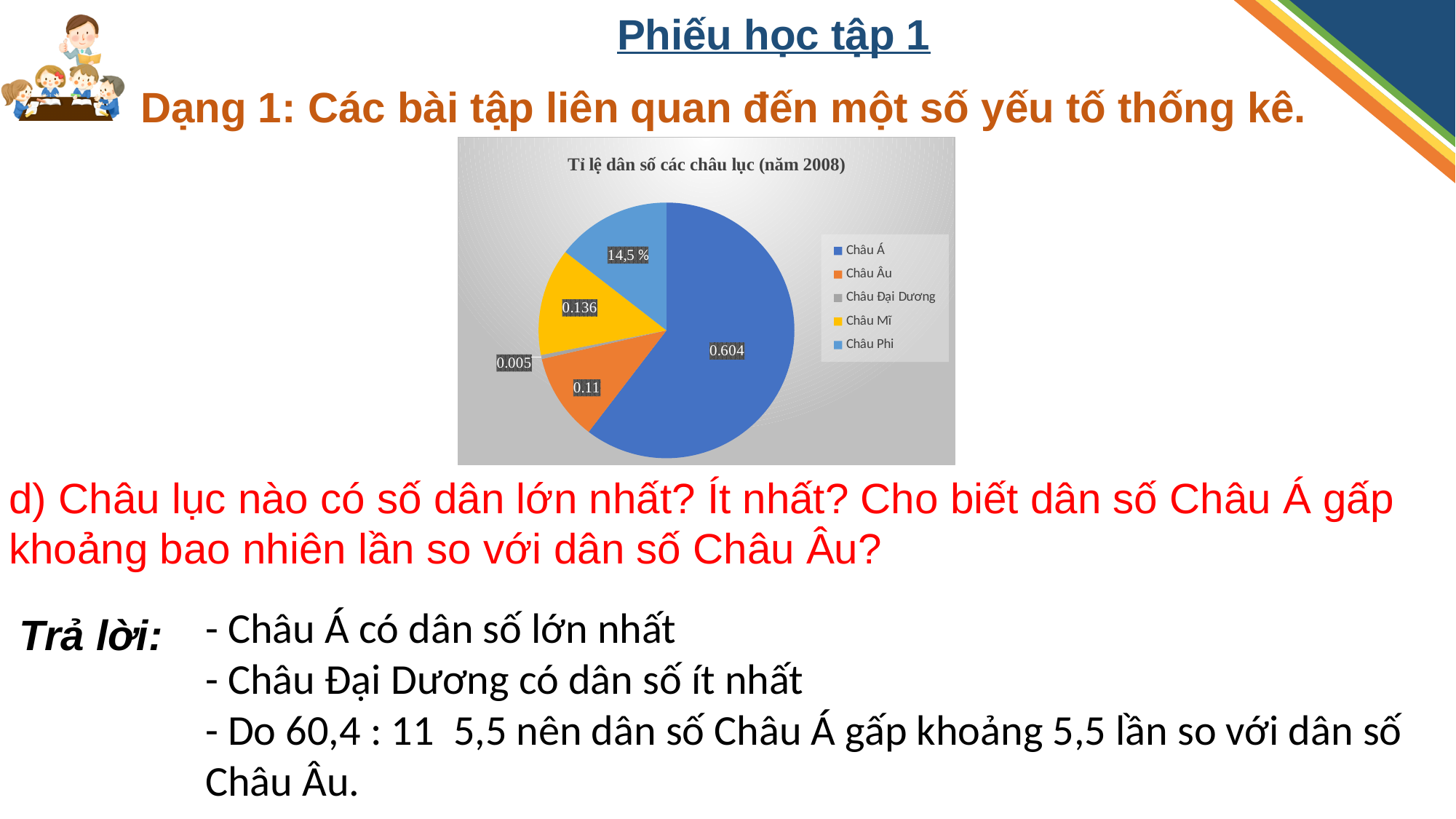
Which continent has the smallest slice of the pie? Châu Đại Dương How many entries does the legend list? 5 Which continent has the largest slice of the pie? Châu Á What value is labelled on the Châu Mĩ slice? 0.136 What value is labelled on the Châu Đại Dương slice? 0.005 What value is labelled on the Châu Phi slice? 14,5 % What value is labelled on the Châu Á slice? 0.604 What is the chart's title? Tỉ lệ dân số các châu lục (năm 2008) Which slice is larger, Châu Mĩ or Châu Âu? Châu Mĩ What value is labelled on the Châu Âu slice? 0.11 What is the difference between the labelled values for Châu Á and Châu Âu? 0.494 What kind of chart is shown on the slide? Pie chart